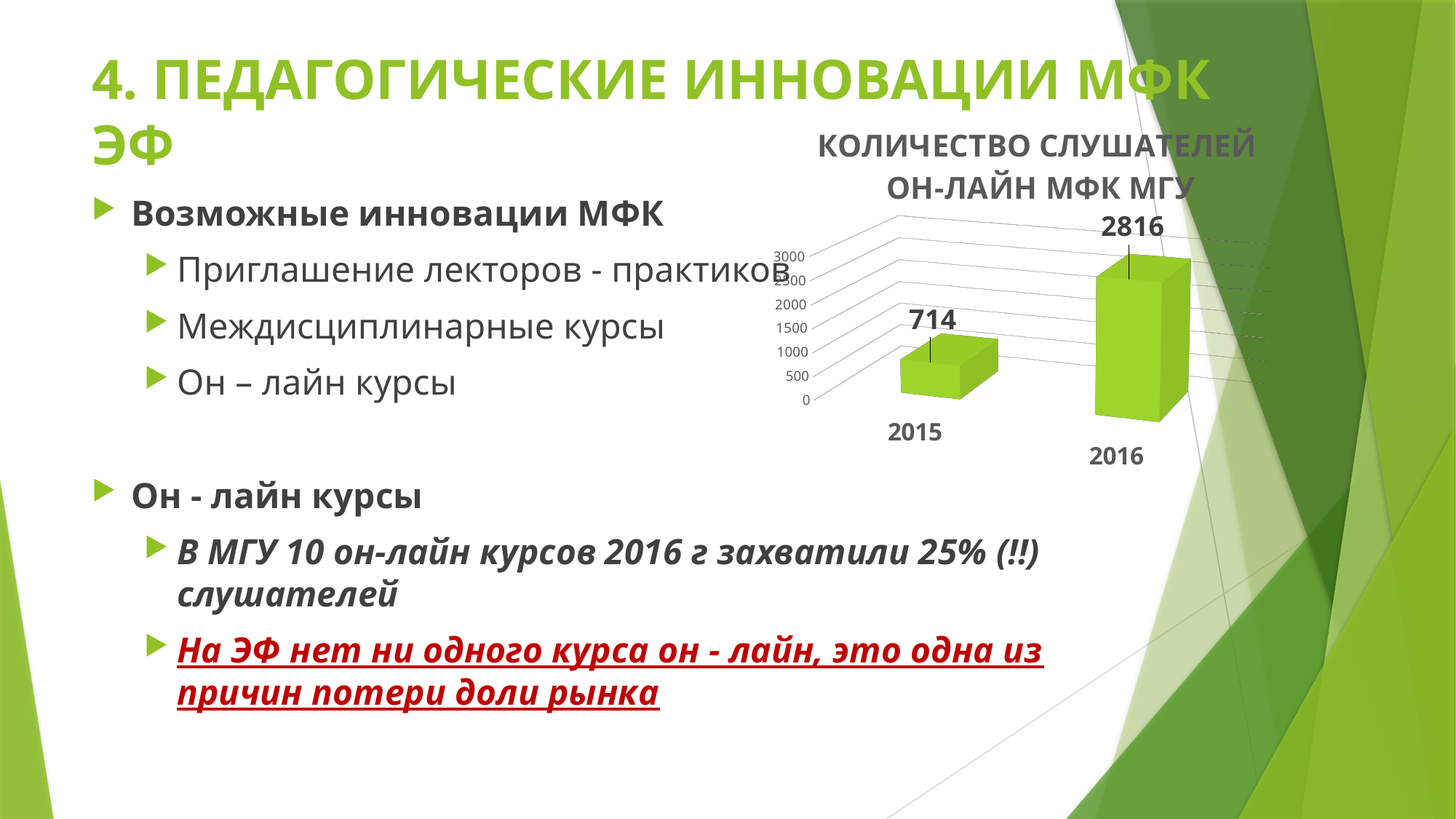
How many categories (years) are shown in the chart? 2 What is the value for 2016 in the chart? 2816 What is the difference between the values for 2016 and 2015? 2102 What kind of chart is shown on the slide? bar chart Do the values rise or fall from 2015 to 2016? rise What is the title of the chart? КОЛИЧЕСТВО СЛУШАТЕЛЕЙ ОН-ЛАЙН МФК МГУ Which year has the highest number of listeners in the chart? 2016 Is the value for 2015 greater or less than 1000? less What is the value for 2015 in the chart? 714 Is the value for 2016 greater or less than 2500? greater Which is larger, the value for 2015 or the value for 2016? 2016 Which year has the lowest number of listeners in the chart? 2015